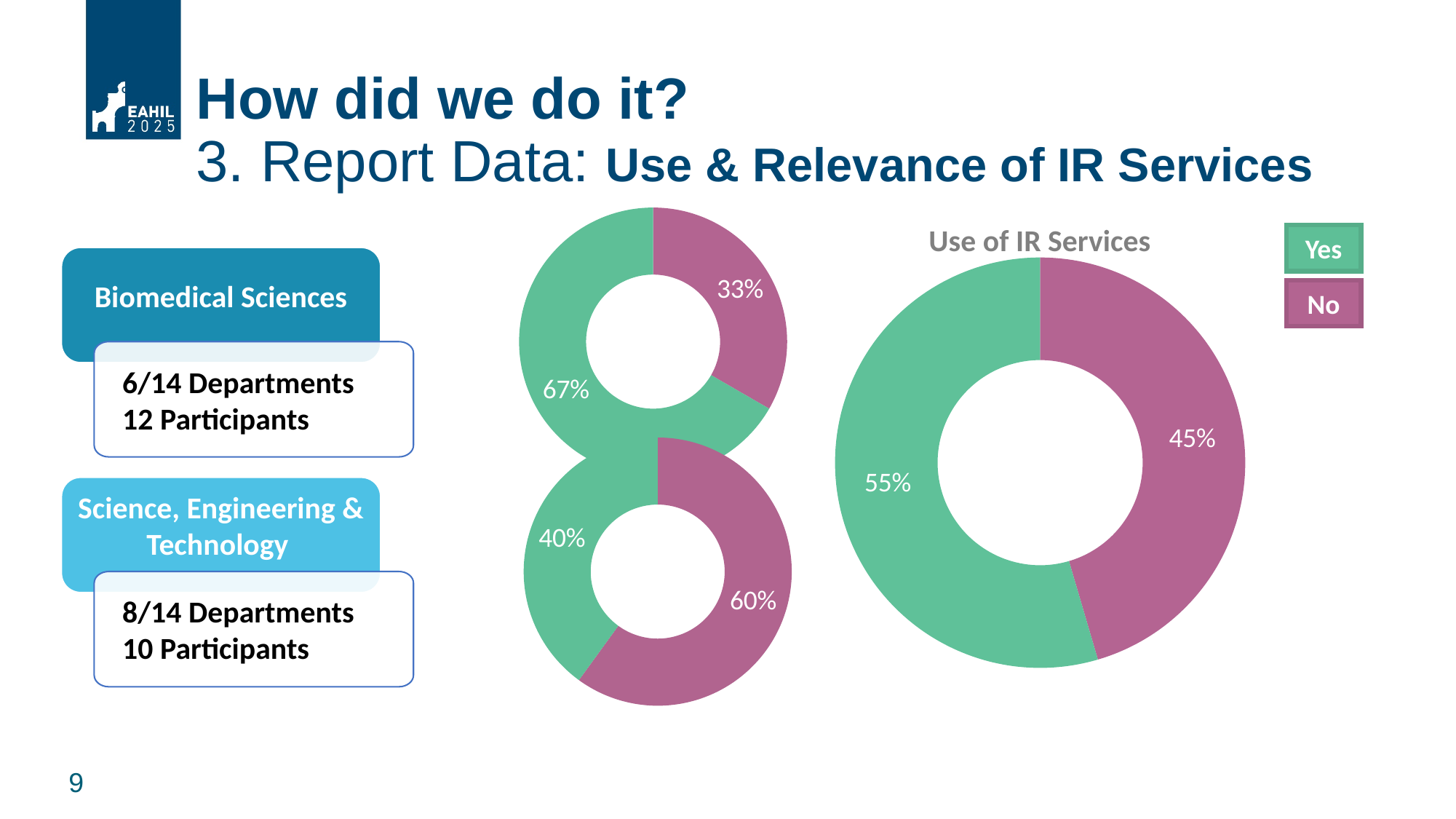
In the upper small doughnut chart in the middle of the slide, what percentage is shown for the green (Yes) segment? 67% In the upper small doughnut chart in the middle of the slide, what is the difference between the Yes and No percentages? 34% In the lower small doughnut chart in the middle of the slide, what percentage is shown for the green (Yes) segment? 40% In the lower small doughnut chart in the middle of the slide, what percentage is shown for the pink (No) segment? 60% In the lower small doughnut chart in the middle of the slide, which segment is larger, Yes or No? No How many entries does the legend on the right of the slide list? 2 In the chart titled "Use of IR Services", what percentage is shown for Yes? 55% In the upper small doughnut chart in the middle of the slide, what percentage is shown for the pink (No) segment? 33% In the chart titled "Use of IR Services", which is larger, Yes or No? Yes What kind of chart is the chart titled "Use of IR Services"? Doughnut chart In the chart titled "Use of IR Services", what percentage is shown for No? 45% In the chart titled "Use of IR Services", what is the difference between the Yes and No percentages? 10%